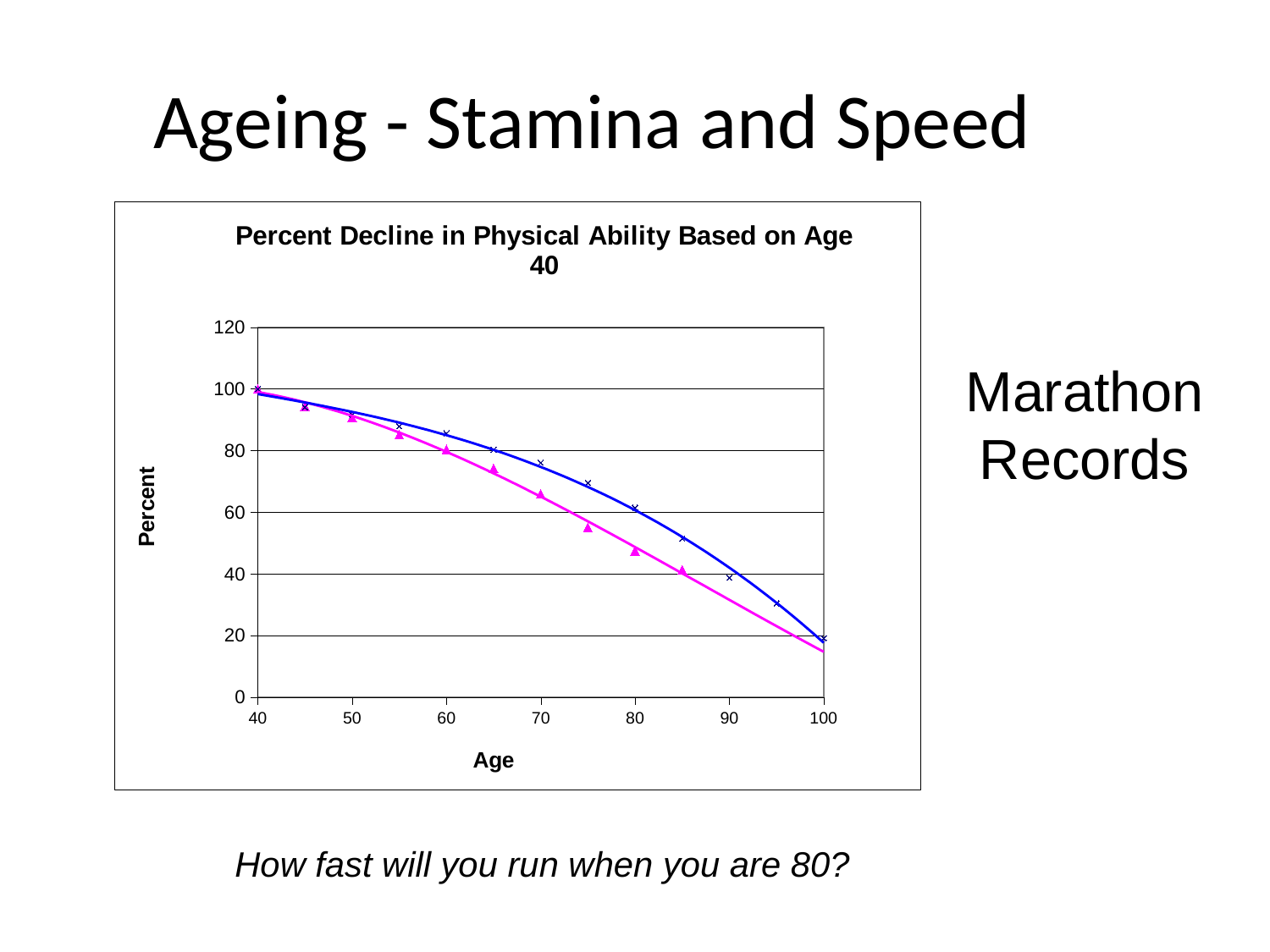
Is the value of the magenta triangle series at age 70 greater or less than 60? greater Do the plotted values rise or fall as age increases along the x axis? Fall What kind of chart is shown on the slide? Scatter chart with fitted curves Is the value of the blue x series at age 70 greater or less than 80? less What is the Percent value for both series at age 40? 100 Is the value of the magenta triangle series at age 80 greater or less than 60? less What is the title of the chart? Percent Decline in Physical Ability Based on Age 40 How many data series are plotted on the chart? 2 At age 80, which series has the higher Percent value, the blue x series or the magenta triangle series? Blue x series